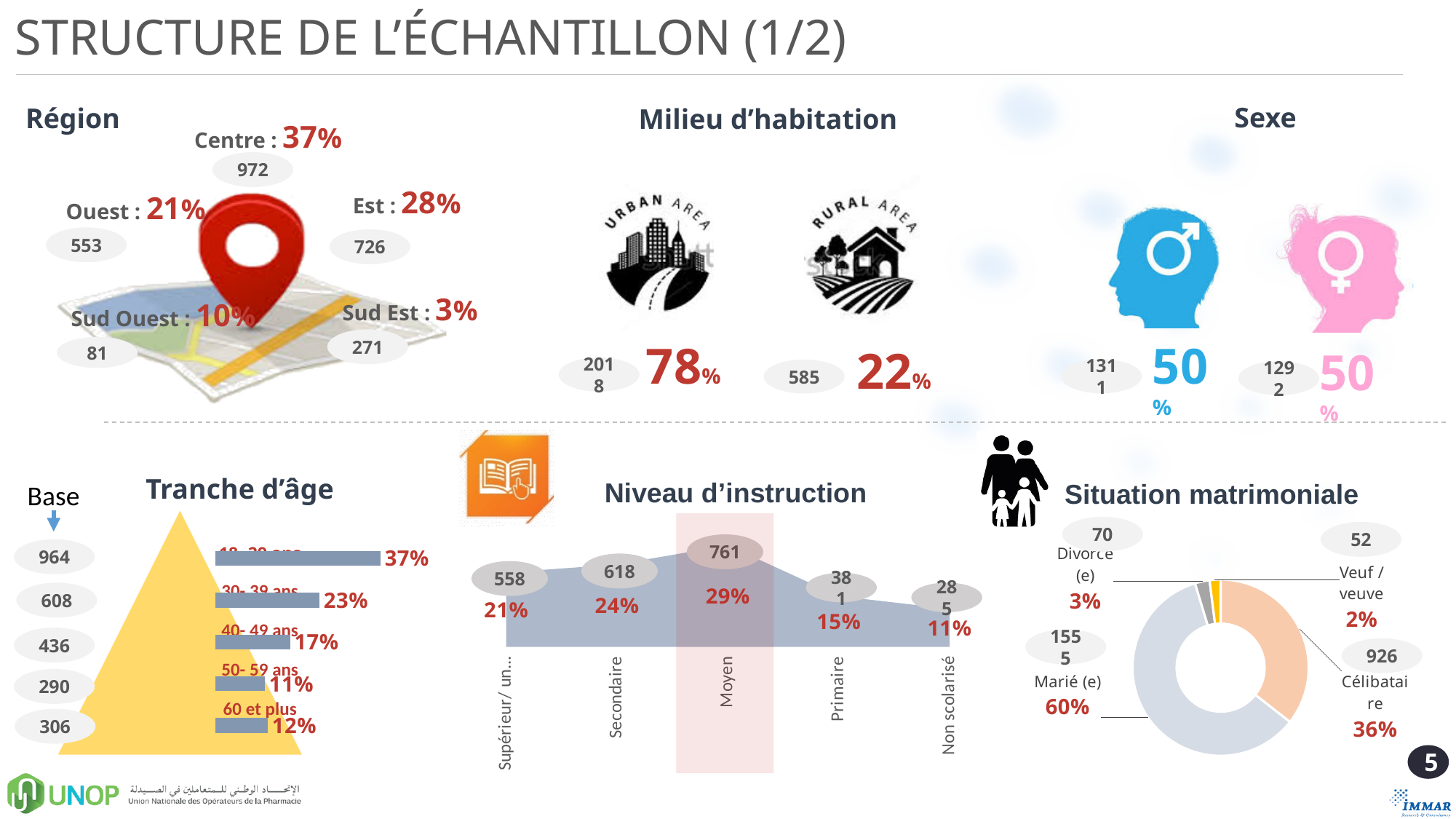
In the 'Tranche d'âge' chart, what percentage is shown for the 18-29 ans age group? 37% In the 'Situation matrimoniale' donut chart, which category has the largest share? Marié (e) In the 'Tranche d'âge' chart, which age group has the lowest percentage? 50-59 ans In the 'Niveau d'instruction' chart, which is larger: the percentage for Supérieur or for Primaire? Supérieur In the 'Niveau d'instruction' chart, what is the count shown for Secondaire? 618 In the 'Niveau d'instruction' chart, which education level has the highest percentage? Moyen In the 'Tranche d'âge' chart, how many age groups are shown? 5 In the 'Milieu d'habitation' section, what percentage is shown for the urban area? 78% In the 'Situation matrimoniale' donut chart, what share is shown for Célibataire? 36% In the 'Tranche d'âge' chart, what is the difference in percentage points between the 30-39 ans and 40-49 ans groups? 6 In the 'Niveau d'instruction' chart, what percentage is shown for Moyen? 29% In the 'Région' section, what percentage is shown for Est? 28%